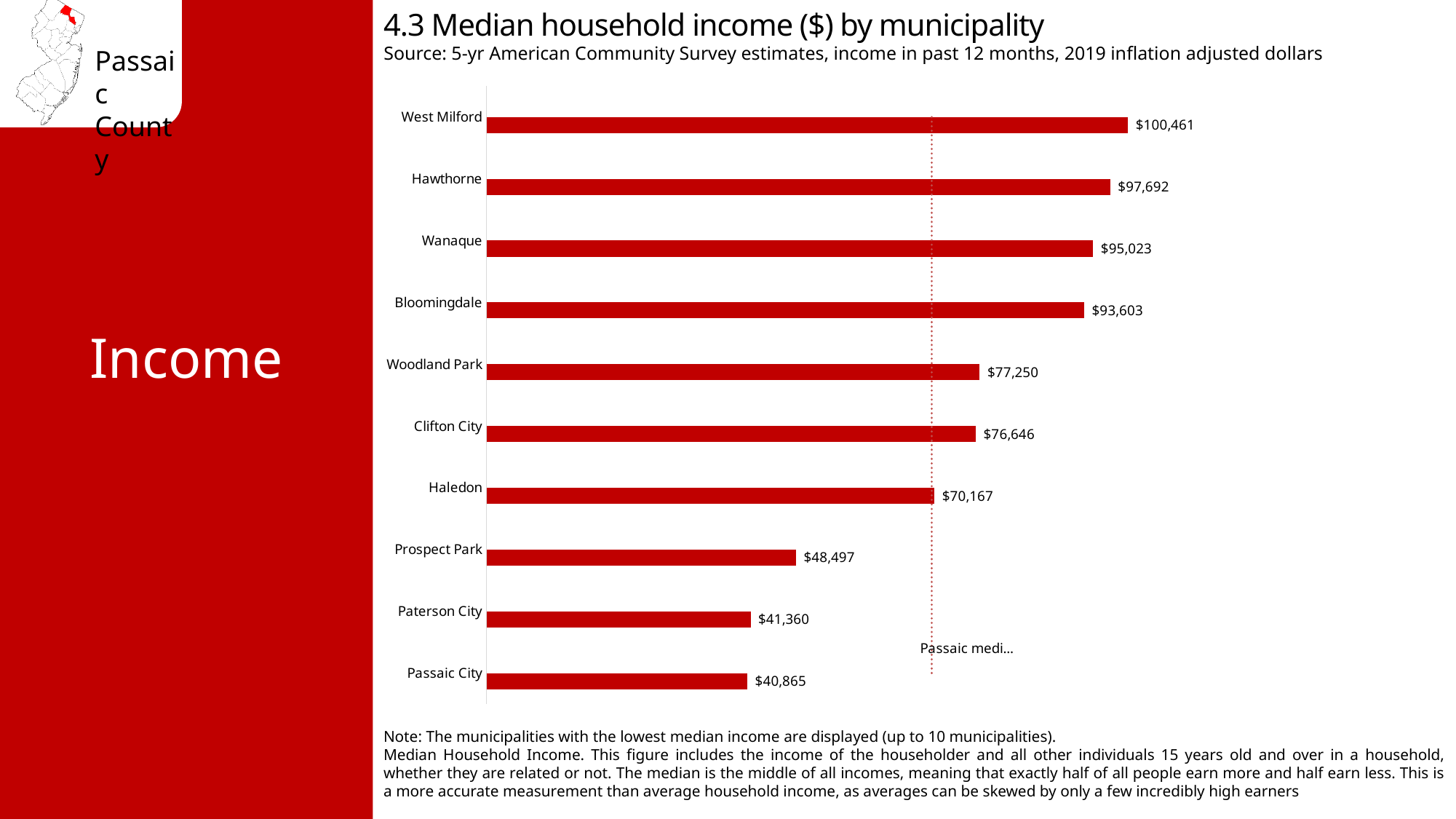
What is the median household income for Prospect Park? $48,497 Do the median household income values increase or decrease going from the top bar to the bottom bar? Decrease What is the difference in median household income between West Milford and Passaic City? $59,596 Which municipality has the lowest median household income on the chart? Passaic City Which has a higher median household income, Bloomingdale or Woodland Park? Bloomingdale What kind of chart is used to show median household income by municipality? Bar chart What is the median household income for Haledon? $70,167 How many municipalities are shown on the chart? 10 Which municipality has the highest median household income on the chart? West Milford What is the difference in median household income between Prospect Park and Paterson City? $7,137 Which has a higher median household income, Haledon or Prospect Park? Haledon What is the median household income for West Milford? $100,461